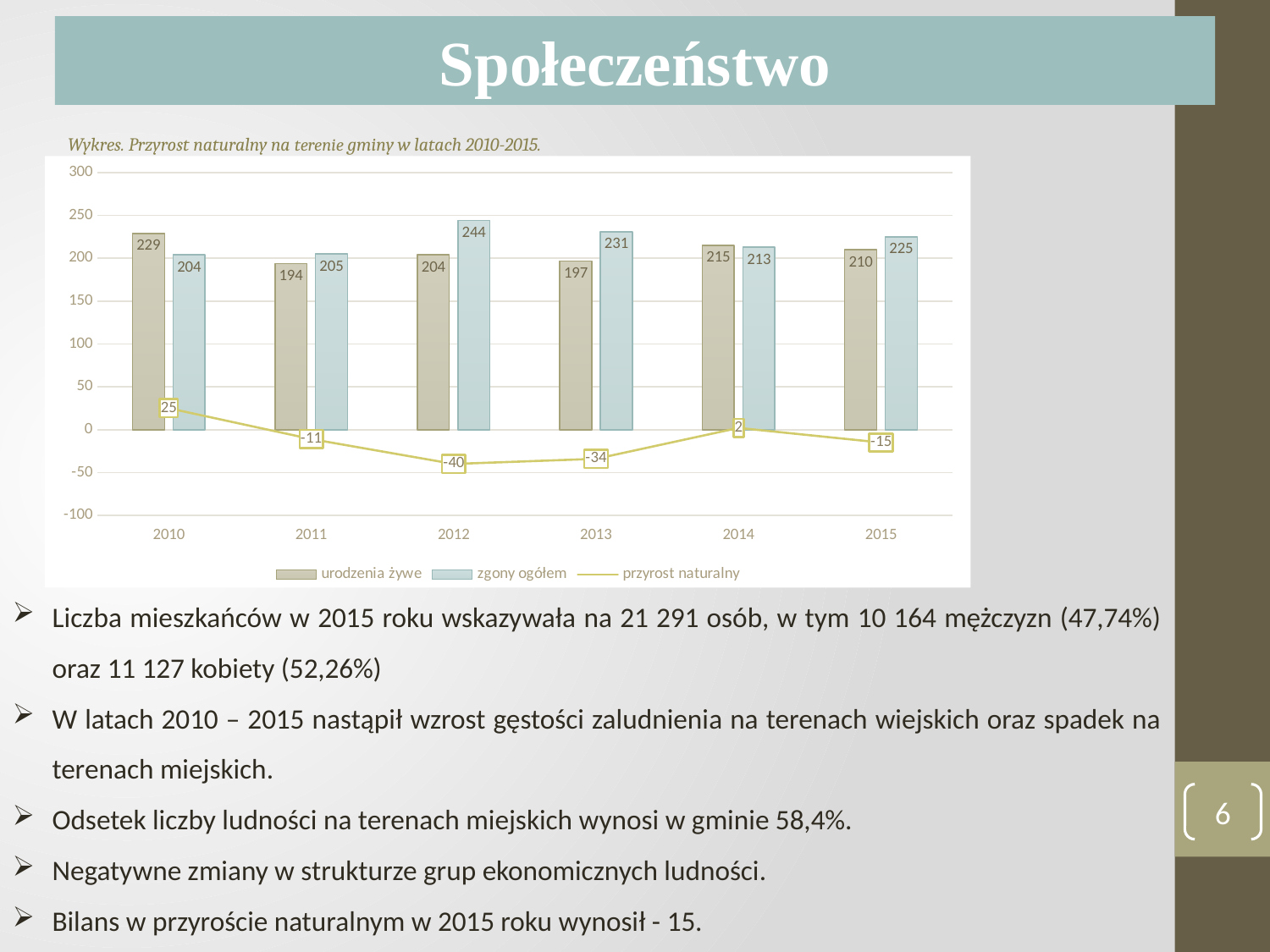
What is the value of urodzenia żywe in 2010? 229 What is the difference between zgony ogółem and urodzenia żywe in 2015? 15 What is the value of zgony ogółem in 2012? 244 How many years are shown on the x axis? 6 In which year is zgony ogółem highest? 2012 What is the value of przyrost naturalny in 2013? -34 Does przyrost naturalny rise or fall from 2010 to 2012? fall Is the value of zgony ogółem in 2013 greater or less than 200? greater Which is larger in 2010, urodzenia żywe or zgony ogółem? urodzenia żywe How many series does the legend list? 3 What is the title of the chart? Wykres. Przyrost naturalny na terenie gminy w latach 2010-2015. In which year is urodzenia żywe lowest? 2011